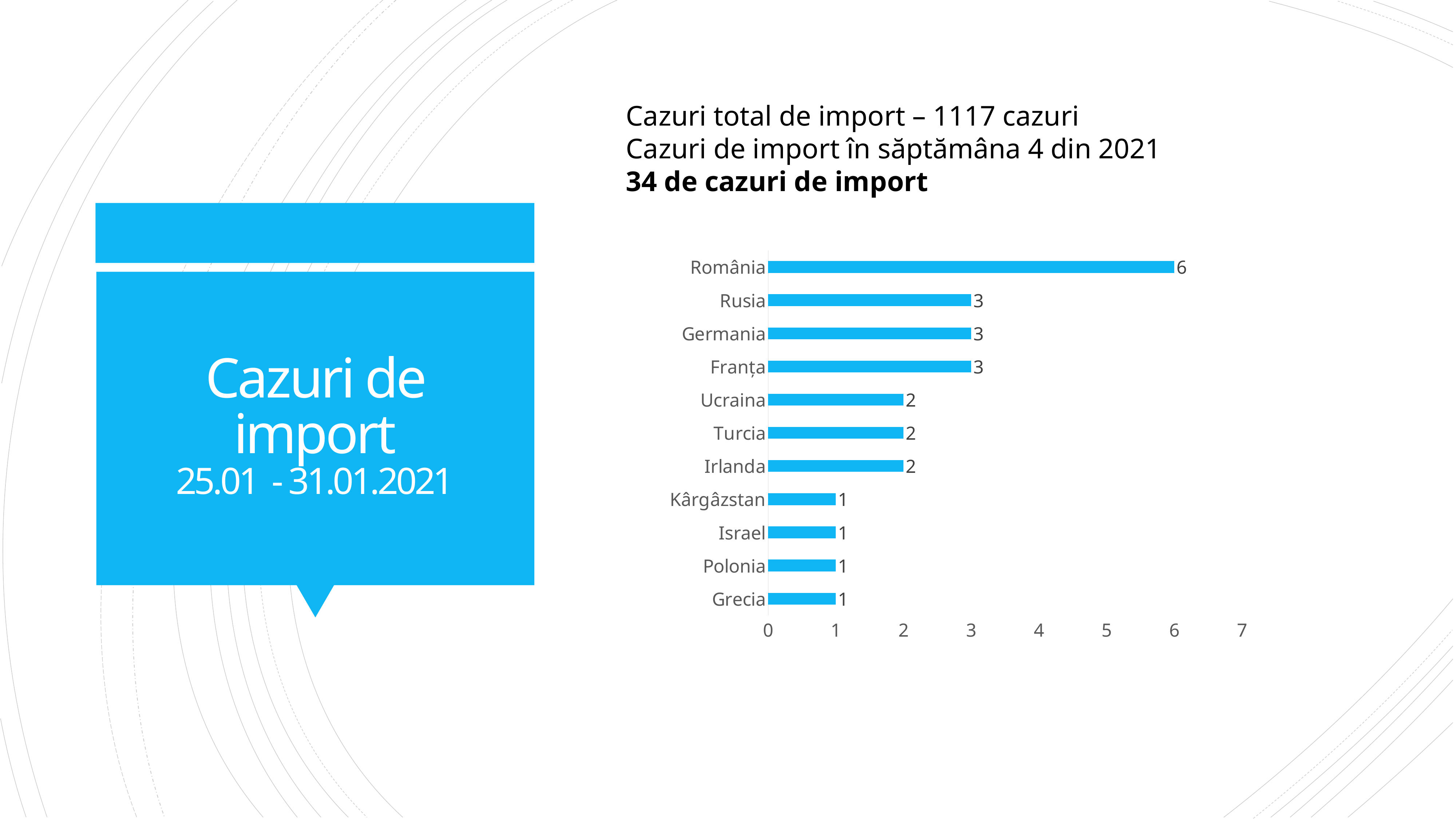
Which country has the highest value? România What is the difference between the values for România and Rusia? 3 Is the value for România greater or less than 5? greater How many countries are shown in the chart? 11 What is the value for România? 6 What is the value for Germania? 3 What is the value for Grecia? 1 What is the highest value shown on the x axis? 7 What is the value for Ucraina? 2 Which is larger, the value for Turcia or the value for Israel? Turcia What is the difference between the values for Franța and Irlanda? 1 What kind of chart is shown on the slide? bar chart